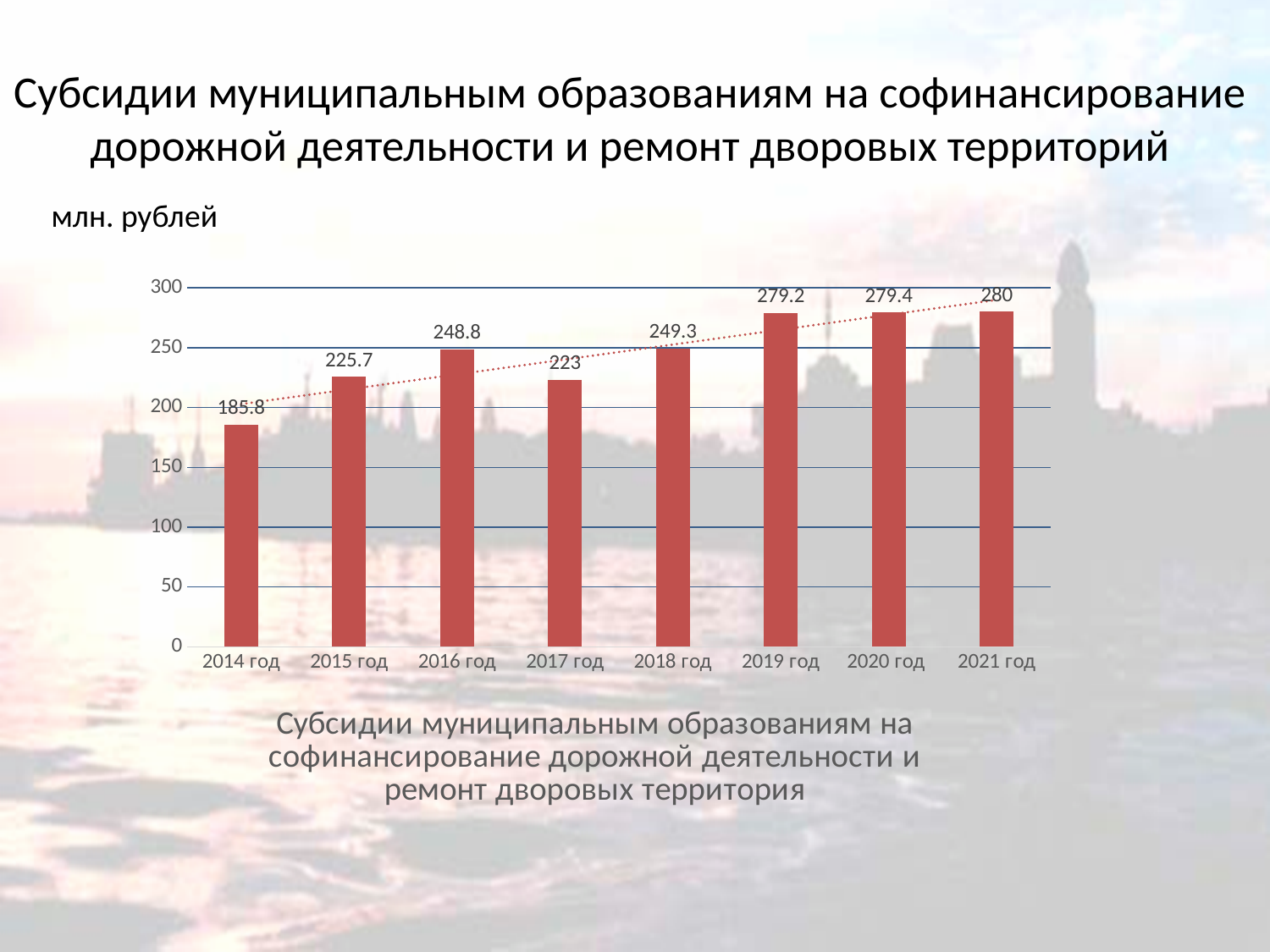
What is the value for 2017 год? 223 What unit is stated above the chart? млн. рублей Is the value for 2015 год greater or less than 200? greater What is the difference between the values for 2021 год and 2014 год? 94.2 What is the value for 2014 год? 185.8 Which year has the lowest value? 2014 год What is the difference between the values for 2016 год and 2017 год? 25.8 Which is larger, the value for 2016 год or the value for 2017 год? 2016 год Which year has the highest value? 2021 год What is the value for 2019 год? 279.2 What kind of chart is this? bar chart How many years are shown on the x axis? 8